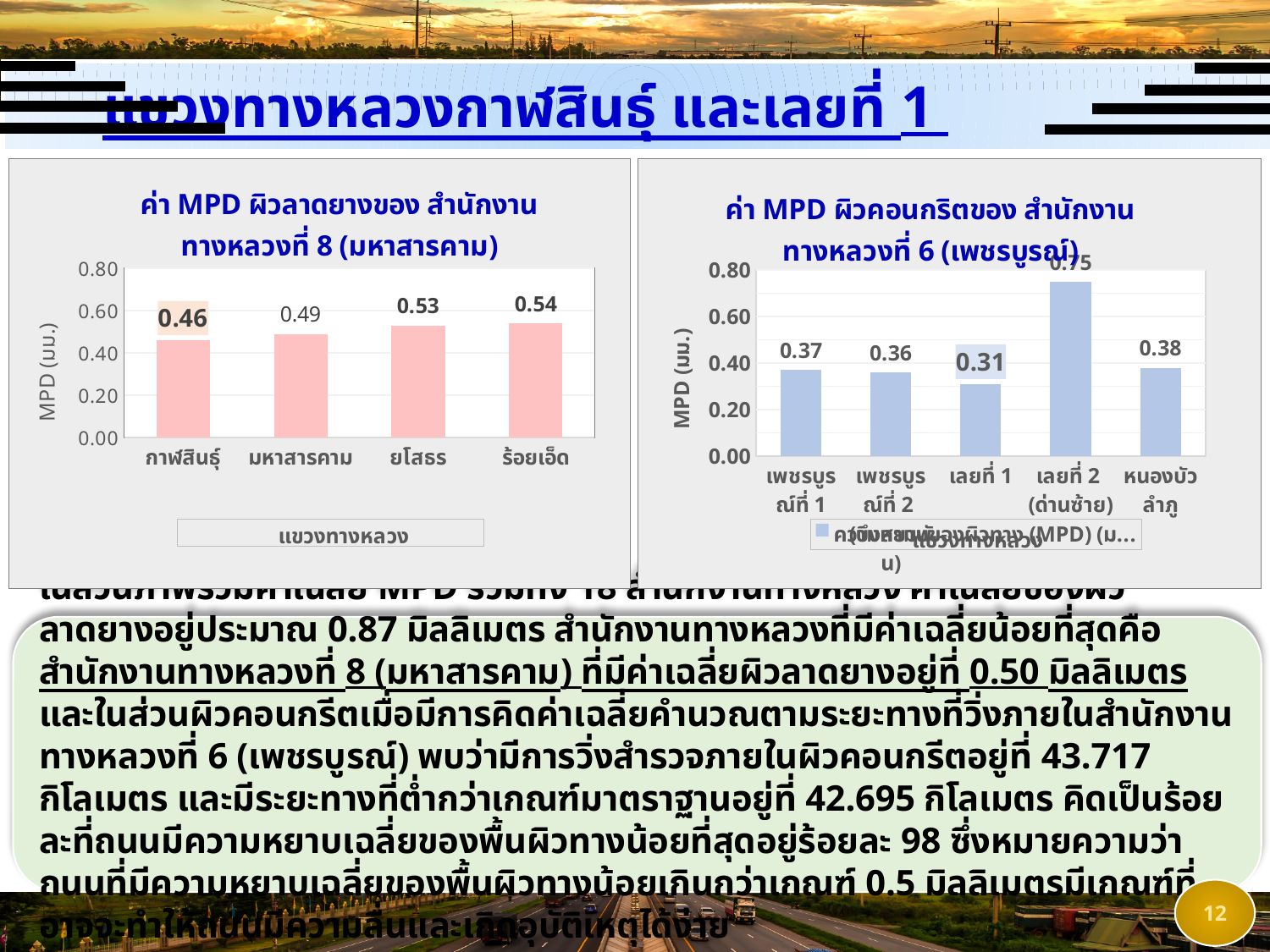
In the left chart (ค่า MPD ผิวลาดยางของ สำนักงานทางหลวงที่ 8), what is the MPD value for ร้อยเอ็ด? 0.54 In the left chart (ค่า MPD ผิวลาดยางของ สำนักงานทางหลวงที่ 8), how many categories are shown on the x axis? 4 In the right chart (ค่า MPD ผิวคอนกรีตของ สำนักงานทางหลวงที่ 6), which category has the highest MPD value? เลยที่ 2 (ด่านซ้าย) In the left chart (ค่า MPD ผิวลาดยางของ สำนักงานทางหลวงที่ 8), what is the difference between the values for ร้อยเอ็ด and กาฬสินธุ์? 0.08 In the right chart (ค่า MPD ผิวคอนกรีตของ สำนักงานทางหลวงที่ 6), is the value for เลยที่ 2 (ด่านซ้าย) greater or less than 0.60? greater What kind of chart is the right chart (ค่า MPD ผิวคอนกรีตของ สำนักงานทางหลวงที่ 6)? bar chart In the left chart (ค่า MPD ผิวลาดยางของ สำนักงานทางหลวงที่ 8), which category has the lowest MPD value? กาฬสินธุ์ In the left chart (ค่า MPD ผิวลาดยางของ สำนักงานทางหลวงที่ 8), do the values rise or fall from left to right along the x axis? rise In the right chart (ค่า MPD ผิวคอนกรีตของ สำนักงานทางหลวงที่ 6), what is the difference between the values for เลยที่ 2 (ด่านซ้าย) and เลยที่ 1? 0.44 In the right chart (ค่า MPD ผิวคอนกรีตของ สำนักงานทางหลวงที่ 6), what is the MPD value for หนองบัวลำภู? 0.38 In the left chart (ค่า MPD ผิวลาดยางของ สำนักงานทางหลวงที่ 8), what is the MPD value for กาฬสินธุ์? 0.46 In the right chart (ค่า MPD ผิวคอนกรีตของ สำนักงานทางหลวงที่ 6), what is the MPD value for เลยที่ 1? 0.31